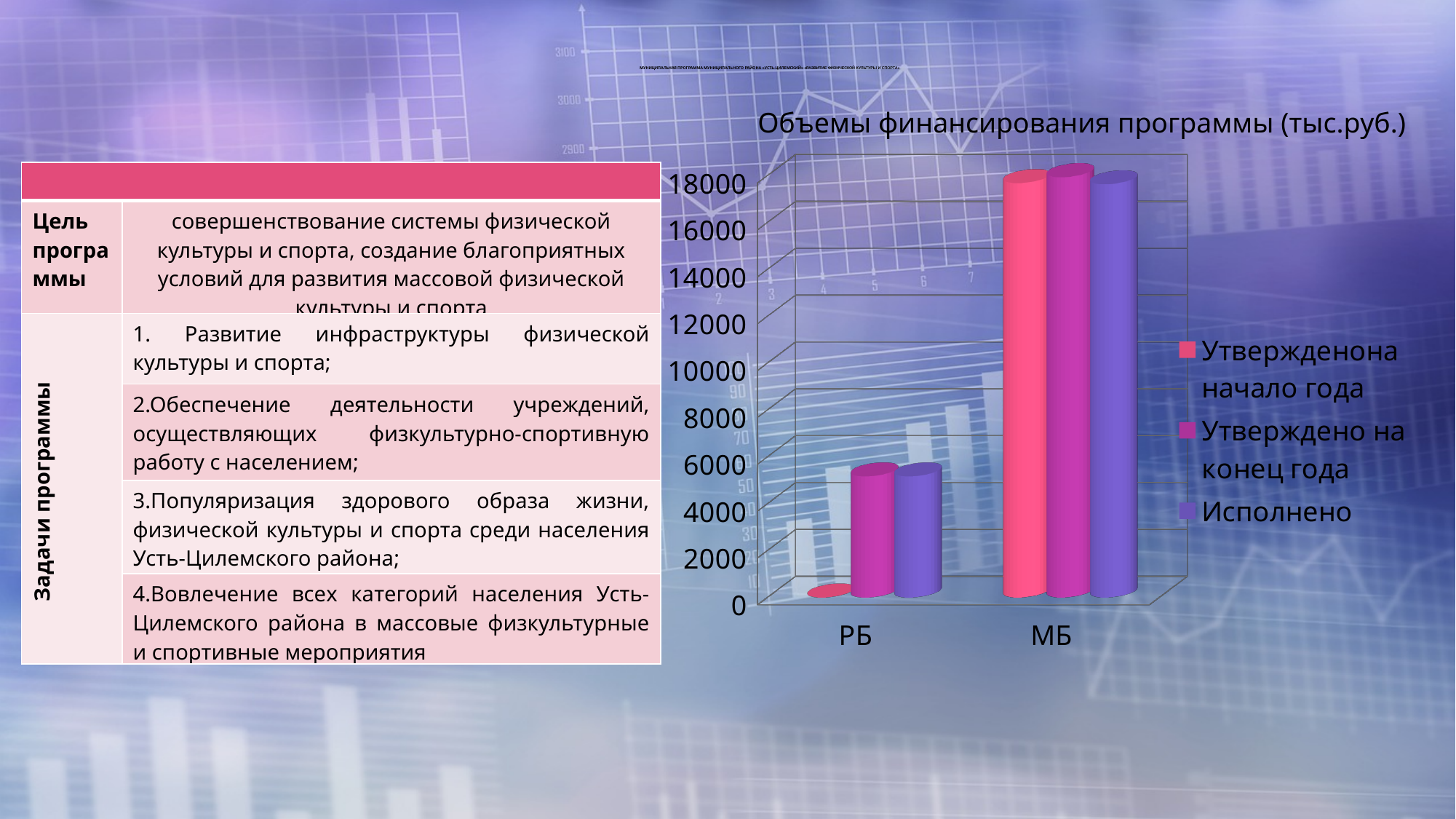
Is the value for Утвержденона начало года in РБ greater or less than 2000? less Which series is shown in purple in the chart legend? Исполнено Which category has the higher values overall, РБ or МБ? МБ How many series does the chart legend list? 3 Within the РБ category, which series has the lowest value? Утвержденона начало года Is the value for Исполнено in МБ greater or less than 14000? greater What is the title of the chart? Объемы финансирования программы (тыс.руб.) Which category has the lowest value for the series Исполнено? РБ What kind of chart is shown on the slide? bar chart How many categories are shown on the x axis of the chart? 2 Is the value for Утверждено на конец года in РБ greater or less than 2000? greater